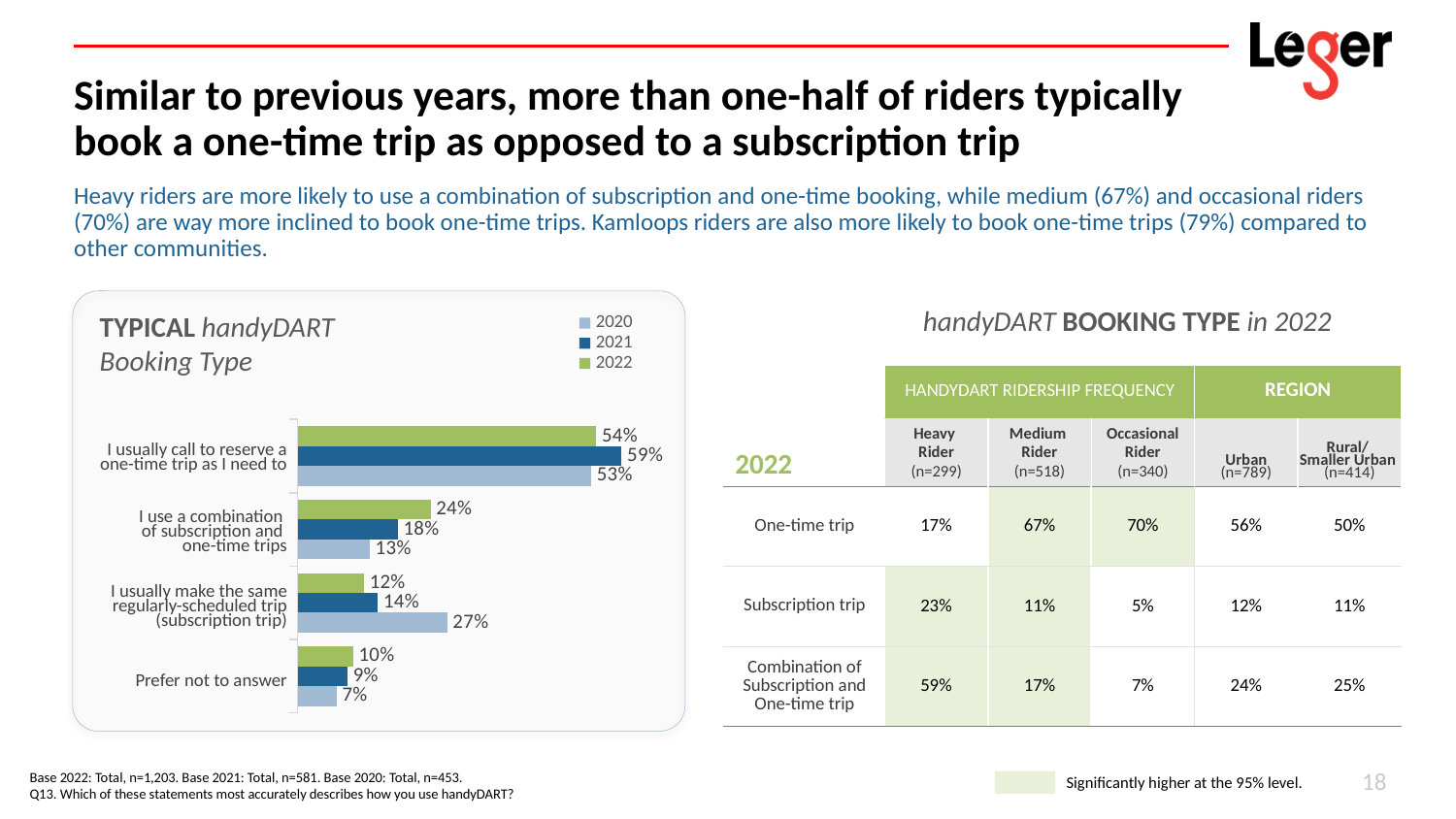
In the TYPICAL handyDART Booking Type chart, what is the difference between the 2022 and 2020 values for "I use a combination of subscription and one-time trips"? 11 percentage points What kind of chart is the TYPICAL handyDART Booking Type chart? Bar chart In the TYPICAL handyDART Booking Type chart, what is the 2022 value for "Prefer not to answer"? 10% In the TYPICAL handyDART Booking Type chart, what is the 2020 value for "I usually make the same regularly-scheduled trip (subscription trip)"? 27% In the TYPICAL handyDART Booking Type chart, which category has the lowest 2020 value? Prefer not to answer In the TYPICAL handyDART Booking Type chart, what is the 2021 value for "I use a combination of subscription and one-time trips"? 18% In the TYPICAL handyDART Booking Type chart, which year has the larger value for "I usually make the same regularly-scheduled trip (subscription trip)": 2020 or 2022? 2020 In the TYPICAL handyDART Booking Type chart, what is the 2022 value for "I usually call to reserve a one-time trip as I need to"? 54% In the TYPICAL handyDART Booking Type chart, which category has the highest 2022 value? I usually call to reserve a one-time trip as I need to How many categories are shown in the TYPICAL handyDART Booking Type chart? 4 In the TYPICAL handyDART Booking Type chart, which colour represents the 2022 series? Green How many series does the legend of the TYPICAL handyDART Booking Type chart list? 3